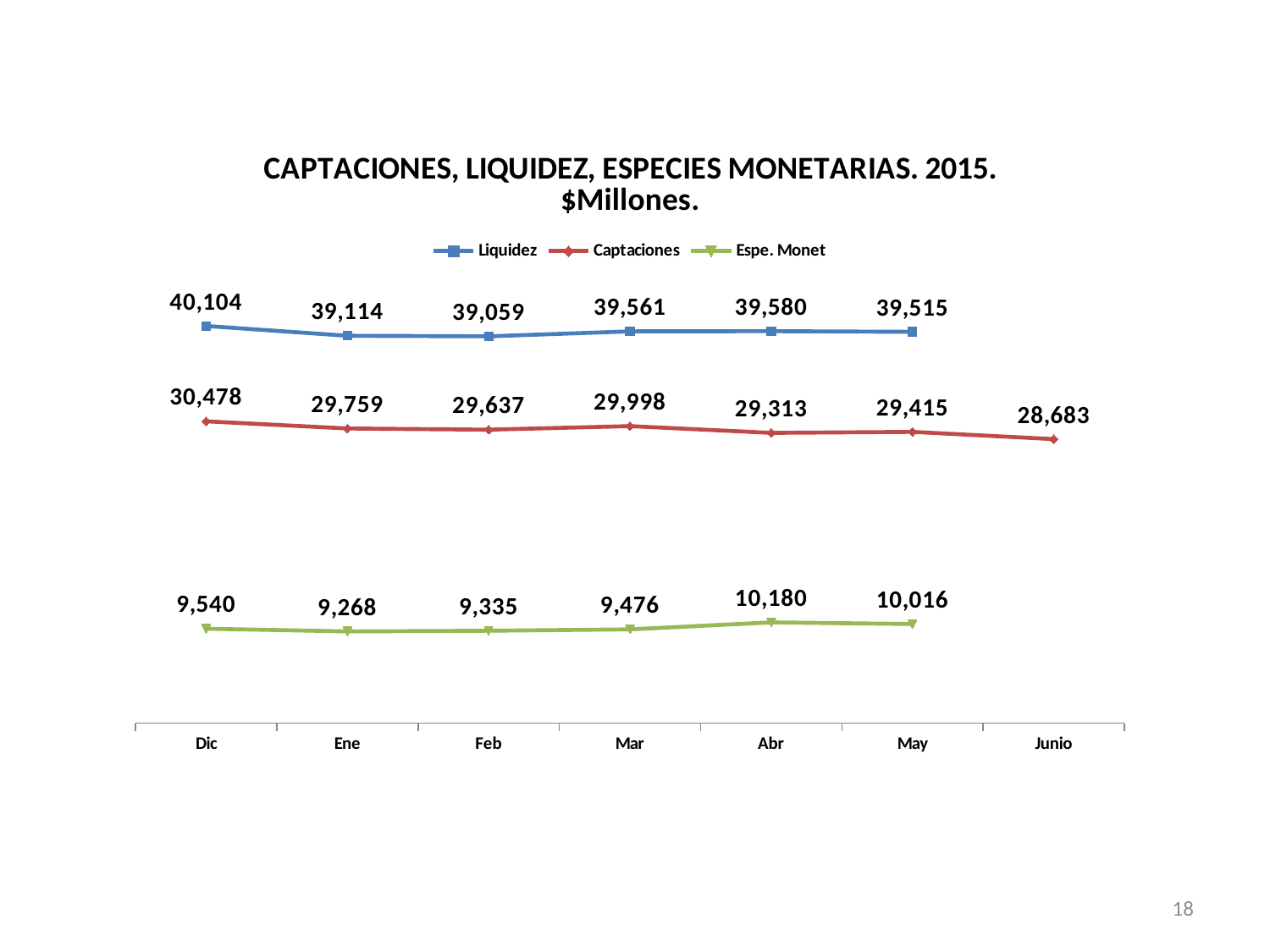
How many months are labelled on the x axis? 7 What is the value of Captaciones in Junio? 28,683 Does Captaciones rise or fall from Dic to Junio overall? fall In which month is Captaciones lowest? Junio How many series does the legend list? 3 What type of chart is shown on the slide? line chart Which is larger, Captaciones in Mar or Captaciones in Abr? Captaciones in Mar What is the value of Espe. Monet in Abr? 10,180 What is the difference between Liquidez in Dic and Liquidez in Feb? 1,045 In which month is Espe. Monet highest? Abr What is the title of the chart? CAPTACIONES, LIQUIDEZ, ESPECIES MONETARIAS. 2015. $Millones. What is the value of Liquidez in Dic? 40,104